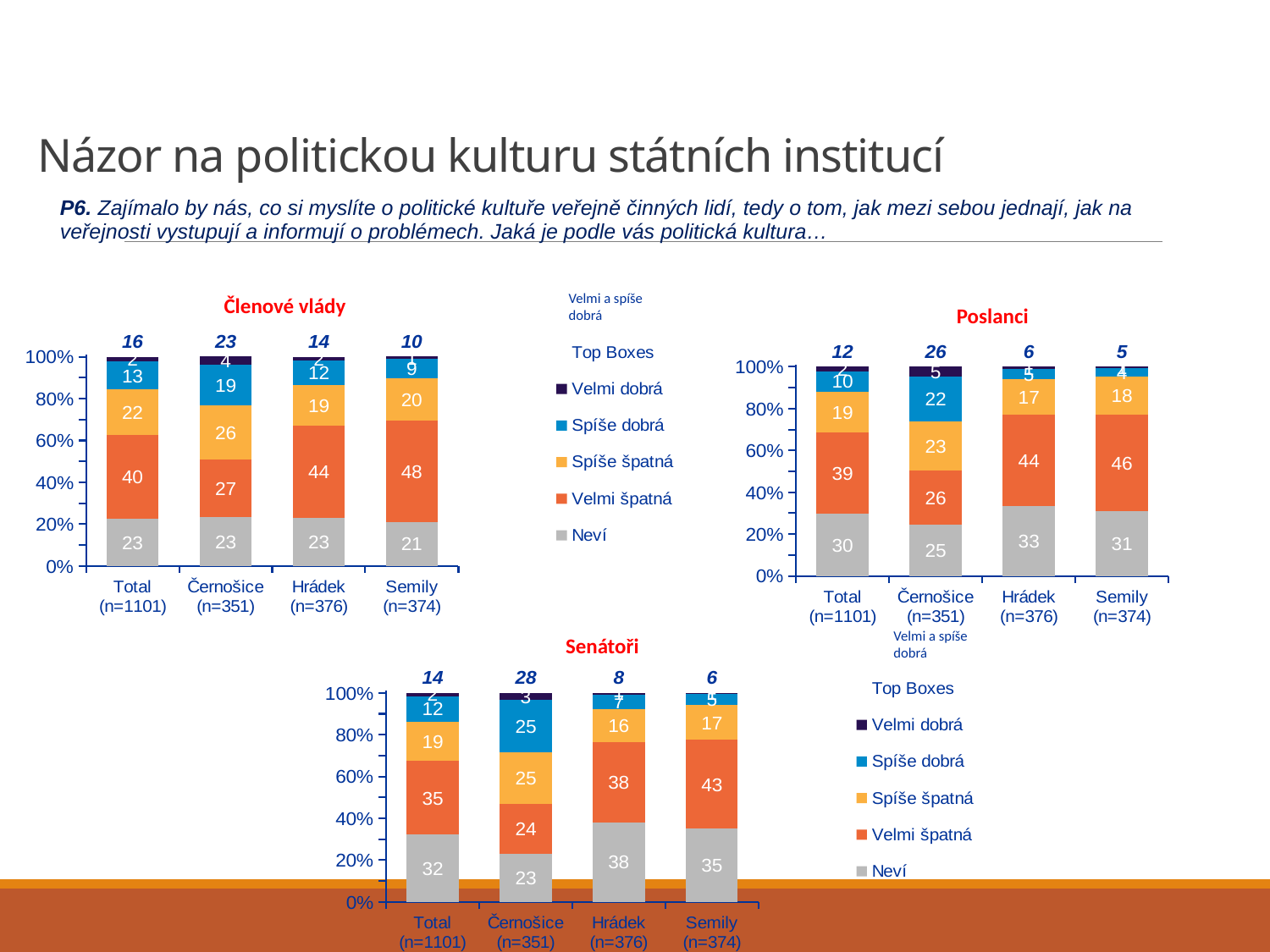
In the 'Poslanci' chart, which category has the highest Top Boxes value? Černošice (n=351) How many series does the legend of the 'Senátoři' chart list? 5 In the 'Senátoři' chart, what Top Boxes value is shown above the Černošice (n=351) bar? 28 In the 'Členové vlády' chart, what is the 'Spíše špatná' value for Černošice (n=351)? 26 In the 'Poslanci' chart, what is the 'Spíše dobrá' value for Černošice (n=351)? 22 In the 'Členové vlády' chart, what is the 'Velmi špatná' value for Semily (n=374)? 48 In the 'Senátoři' chart, what is the 'Velmi špatná' value for Semily (n=374)? 43 In the 'Poslanci' chart, which is larger: the 'Velmi špatná' value for Hrádek (n=376) or for Total (n=1101)? Hrádek (n=376) What kind of chart is the 'Členové vlády' chart? Stacked bar chart In the 'Členové vlády' chart, which category has the lowest Top Boxes value? Semily (n=374) In the 'Poslanci' chart, what is the 'Neví' value for Hrádek (n=376)? 33 In the 'Senátoři' chart, what is the difference between the 'Velmi špatná' values for Semily (n=374) and Černošice (n=351)? 19